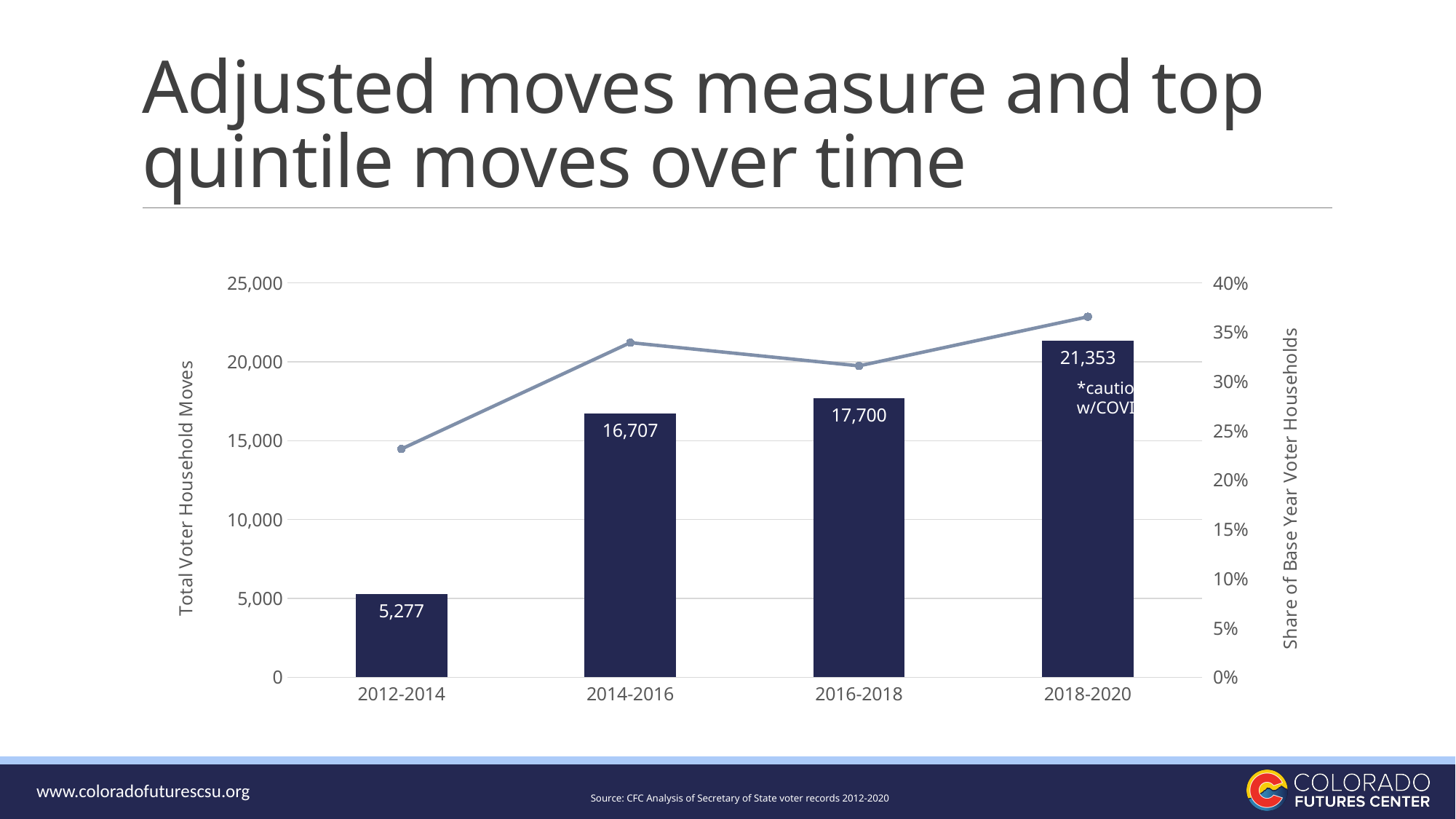
What is the value of Total Voter Household Moves for 2012-2014? 5,277 Which period has the highest Total Voter Household Moves? 2018-2020 What is the value of Total Voter Household Moves for 2018-2020? 21,353 Is the Share of Base Year Voter Households for 2012-2014 greater or less than 25%? less Do the Total Voter Household Moves bars rise or fall from 2012-2014 to 2018-2020? rise What is the value of Total Voter Household Moves for 2014-2016? 16,707 What is the difference in Total Voter Household Moves between 2018-2020 and 2012-2014? 16,076 Which period has the lowest Total Voter Household Moves? 2012-2014 Which period has more Total Voter Household Moves, 2014-2016 or 2016-2018? 2016-2018 How many time periods are shown on the x axis? 4 Is the Share of Base Year Voter Households for 2014-2016 greater or less than 30%? greater What is the value of Total Voter Household Moves for 2016-2018? 17,700